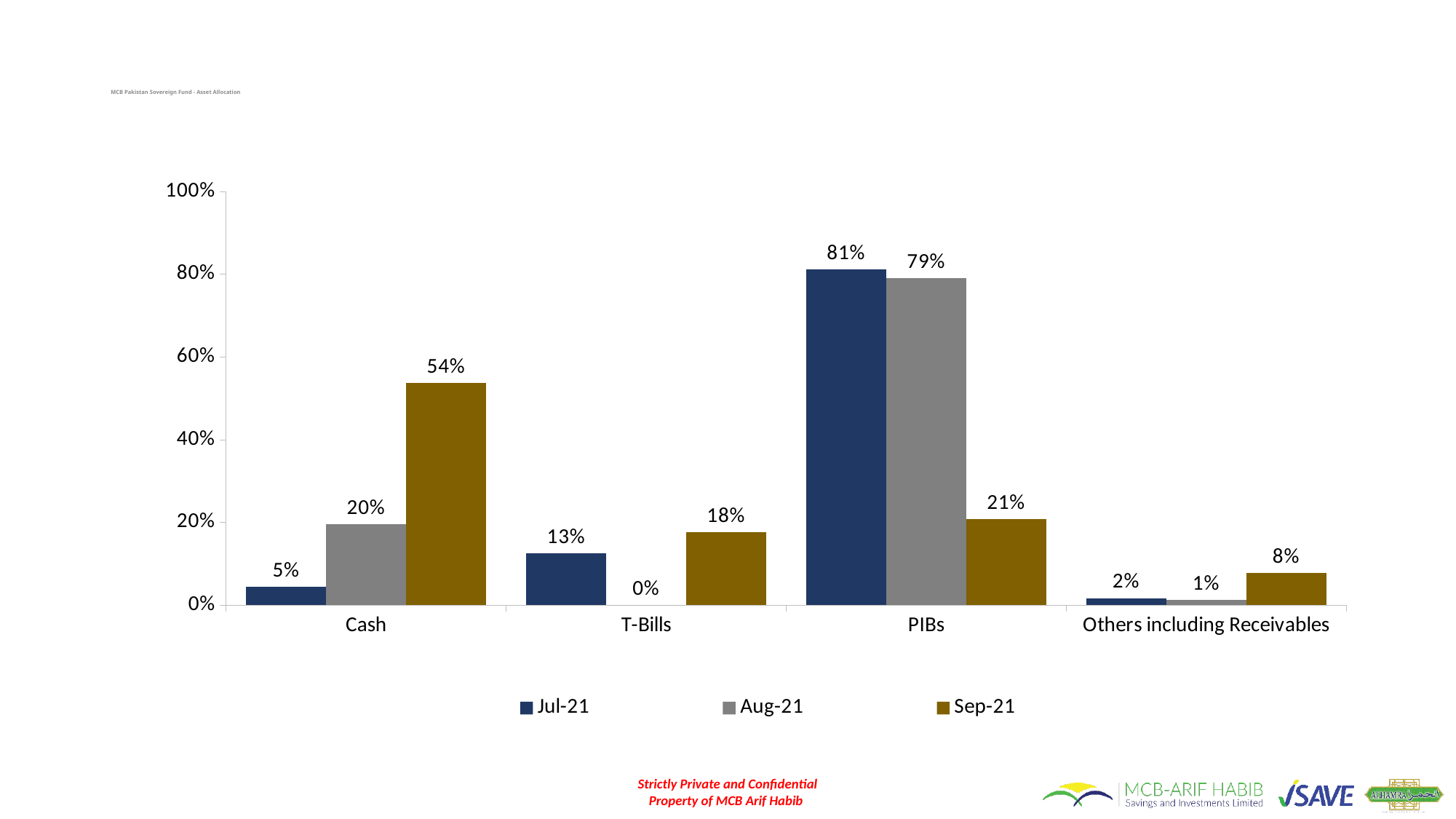
What is the difference between the Jul-21 and Sep-21 values for PIBs? 60% What is the Jul-21 value for PIBs? 81% How many series does the legend list? 3 What is the Sep-21 value for Cash? 54% Which category has the highest Aug-21 value? PIBs What is the Sep-21 value for Others including Receivables? 8% Which category has the lowest Sep-21 value? Others including Receivables How many categories are shown on the x axis? 4 What kind of chart is shown on the slide? Bar chart Which is larger for Cash: the Aug-21 value or the Sep-21 value? Sep-21 What is the Aug-21 value for T-Bills? 0% Which series is shown in gold/brown in the legend? Sep-21